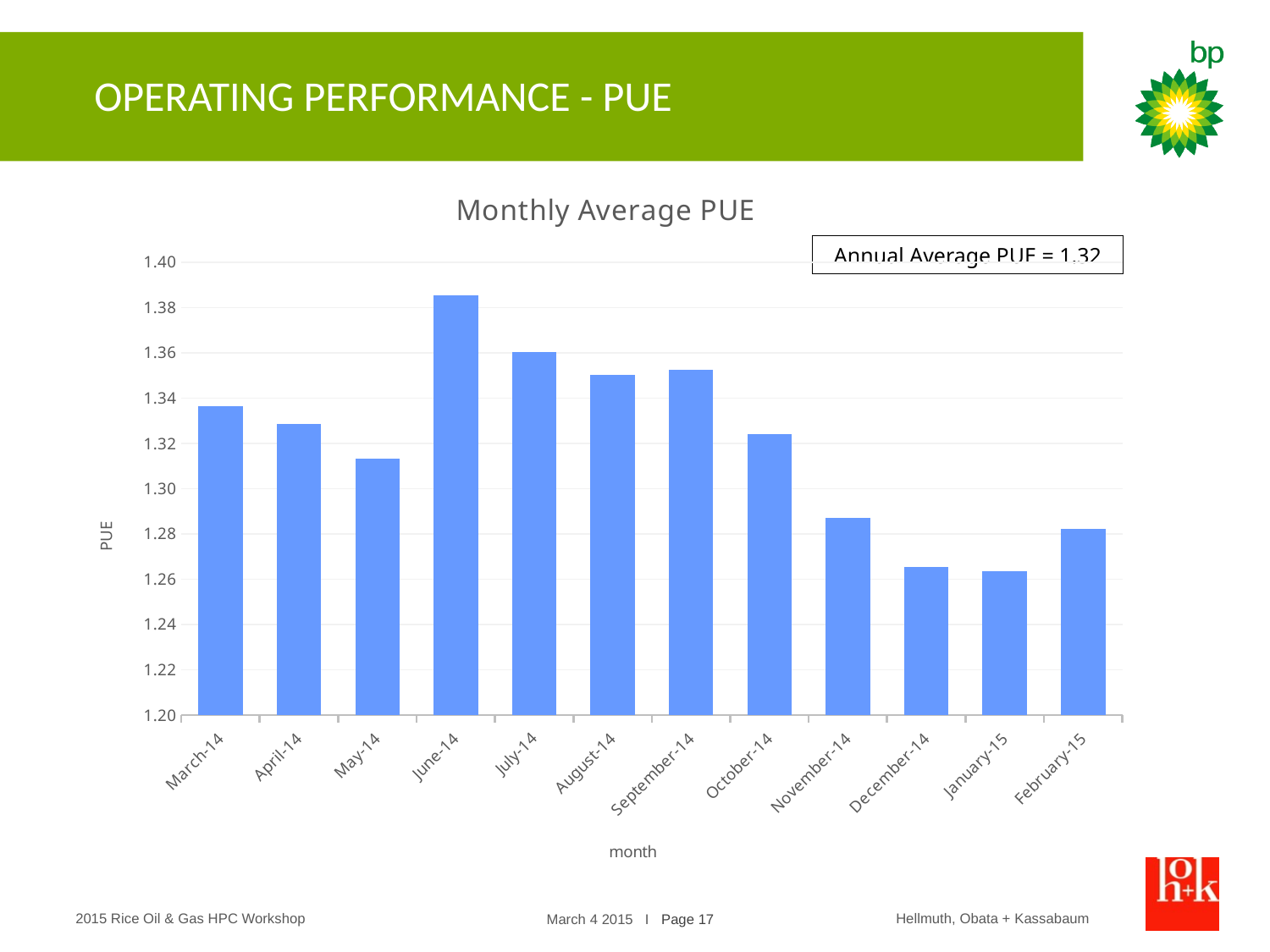
Is the value for May-14 greater or less than 1.32? less Which is larger, the PUE for June-14 or the PUE for March-14? June-14 How many months are plotted on the chart? 12 Which is larger, the PUE for October-14 or the PUE for November-14? October-14 Which month has the highest monthly average PUE? June-14 Do the PUE values rise or fall from September-14 to January-15? fall Is the value for June-14 greater or less than 1.36? greater Is the value for October-14 greater or less than 1.30? greater What annual average PUE is stated in the text box on the chart? 1.32 What type of chart is shown on the slide? bar chart What is the title of the chart? Monthly Average PUE